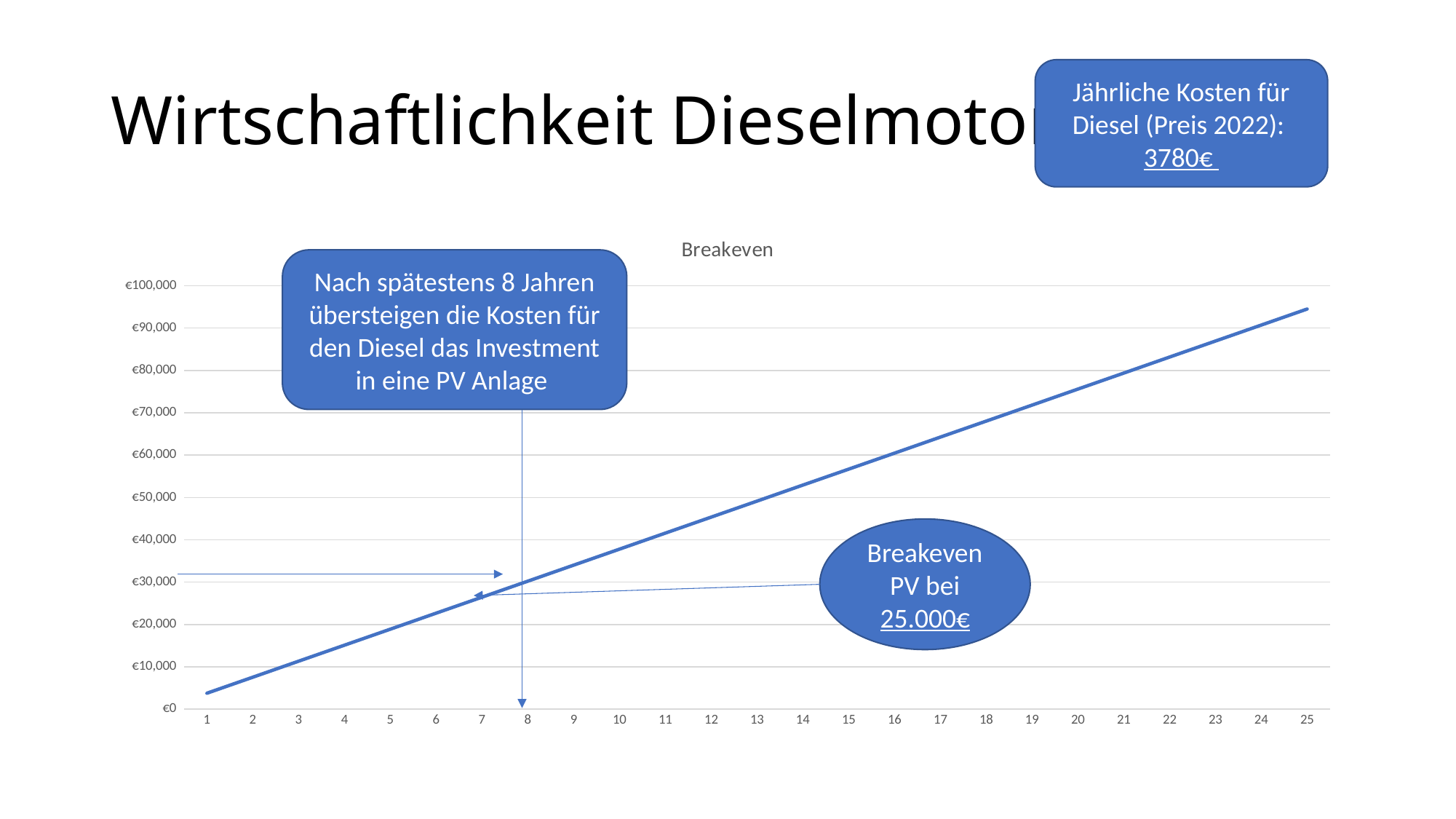
Is the value at x = 1 greater or less than €10,000? less At which x-axis value is the plotted line highest? 25 Is the value at x = 13 greater or less than €40,000? greater Is the value at x = 5 greater or less than €30,000? less Do the values rise or fall along the x axis from 1 to 25? rise What kind of chart is shown on the slide? line chart According to the annotation on the slide, what is the breakeven value for PV? 25.000€ How many points are plotted along the x axis of the chart? 25 At which x-axis value is the plotted line lowest? 1 What is the title of the chart? Breakeven Which has the larger value, x = 10 or x = 20? 20